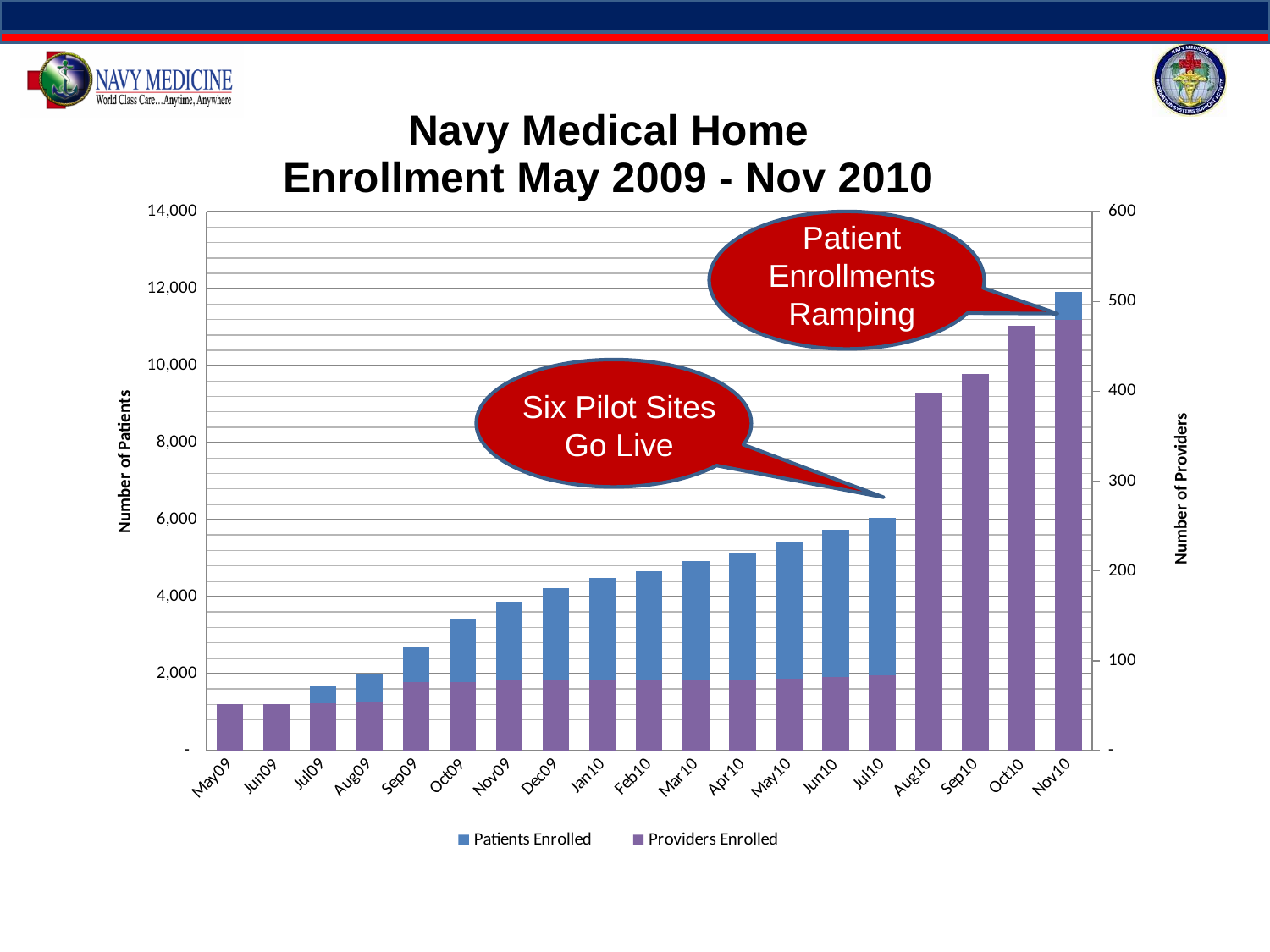
Which month has the highest number of Patients Enrolled? Nov10 Do the Patients Enrolled values generally rise or fall from May09 to Nov10? Rise How many series does the legend list? 2 Is the Providers Enrolled value for Jul10 greater or less than 100 on the right axis? less Is the Providers Enrolled value for Aug10 greater or less than 300 on the right axis? greater What is the title of the chart? Navy Medical Home Enrollment May 2009 - Nov 2010 What is the label of the right-hand vertical axis? Number of Providers What kind of chart is shown on the slide? Bar chart Is the Patients Enrolled value for Jul10 greater or less than 8,000? less How many months are shown along the x axis? 19